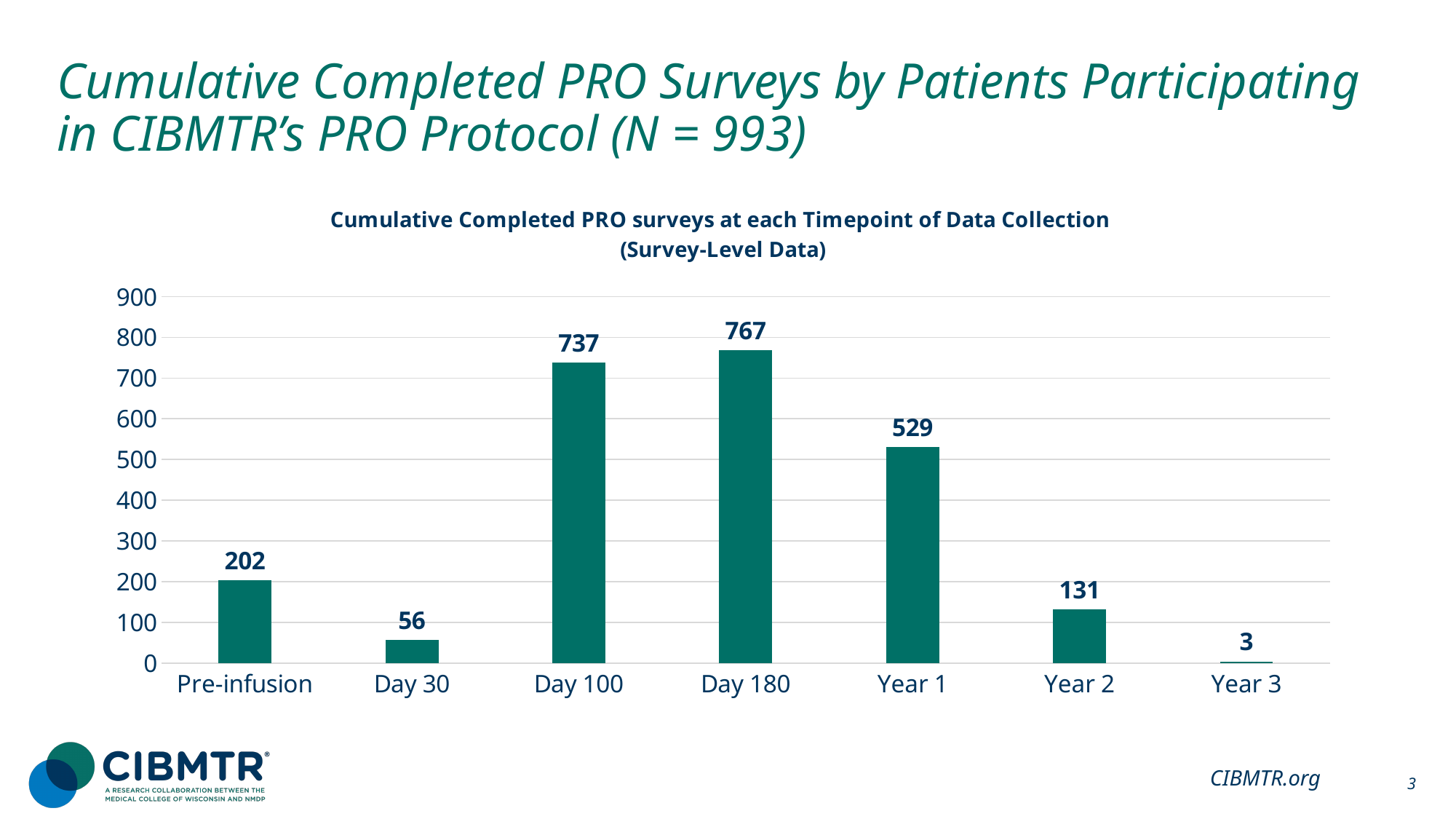
What is the difference between the values for Year 1 and Year 2? 398 Which timepoint has the lowest number of cumulative completed PRO surveys? Year 3 What kind of chart is shown on the slide? Bar chart What is the value for Year 2? 131 Which timepoint has the highest number of cumulative completed PRO surveys? Day 180 What is the value for Day 100? 737 What is the difference between the values for Day 180 and Day 100? 30 Which is larger, the value for Pre-infusion or the value for Day 30? Pre-infusion What is the title of the chart? Cumulative Completed PRO surveys at each Timepoint of Data Collection (Survey-Level Data) Is the value for Year 1 greater or less than 500? greater What is the value for Pre-infusion? 202 How many timepoints are shown on the x axis? 7